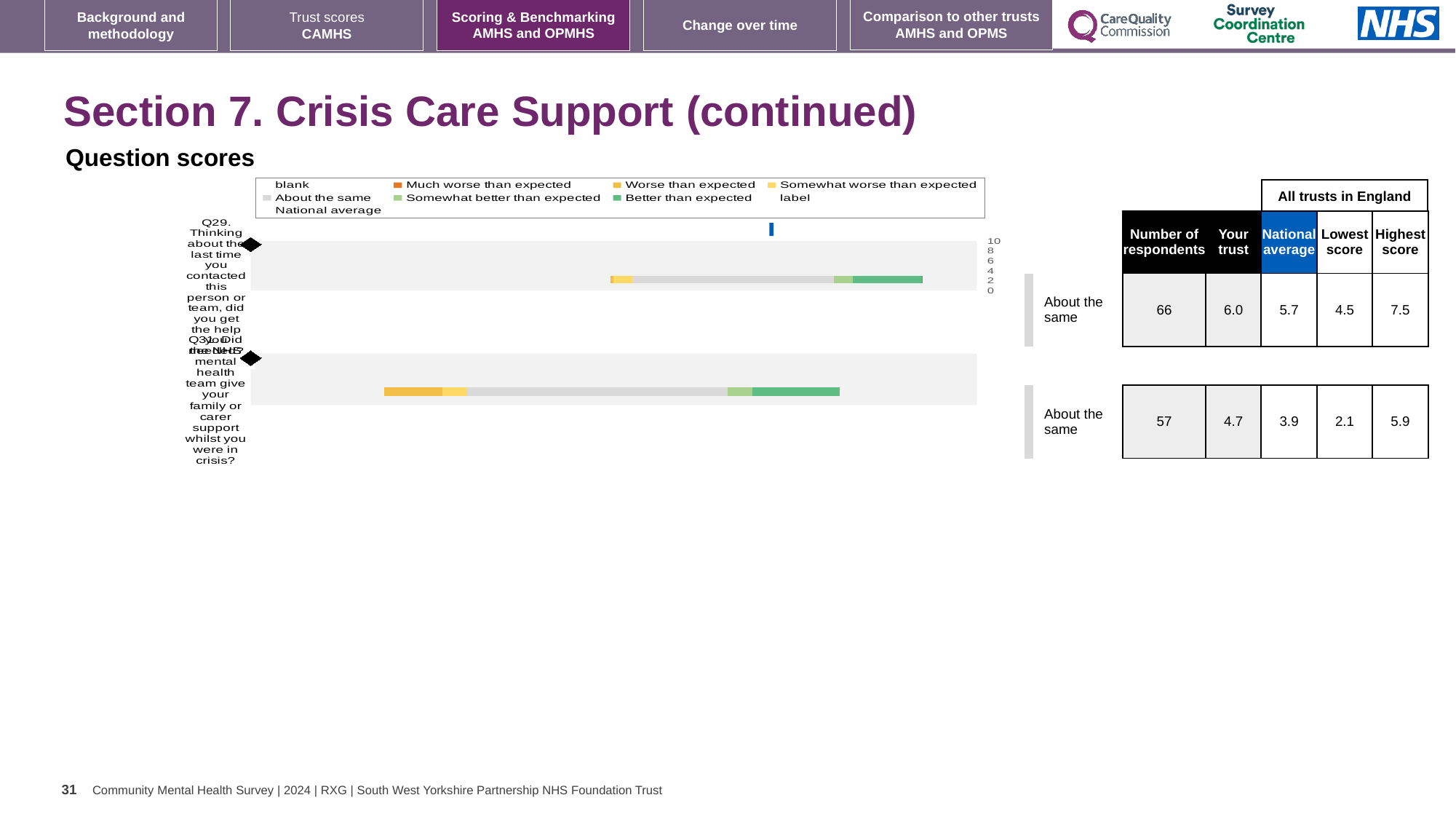
According to the table next to the chart, what is the 'Your trust' score for Q29? 6.0 How many entries does the legend of the question scores chart list? 9 How many questions (categories) are plotted in the question scores chart? 2 According to the table next to the chart, what is the difference between the trust's score and the national average for Q31? 0.8 According to the table next to the chart, what is the highest score among all trusts in England for Q31? 5.9 What kind of chart is used to show the question scores on this slide? bar chart According to the table next to the chart, which question has the higher 'Your trust' score, Q29 or Q31? Q29 In the question scores chart legend, which colour represents 'Better than expected'? green According to the table next to the chart, what is the lowest score among all trusts in England for Q29? 4.5 In the question scores chart legend, which colour represents 'About the same'? grey According to the table next to the chart, what is the national average for Q31? 3.9 According to the table next to the chart, how many respondents answered Q29? 66